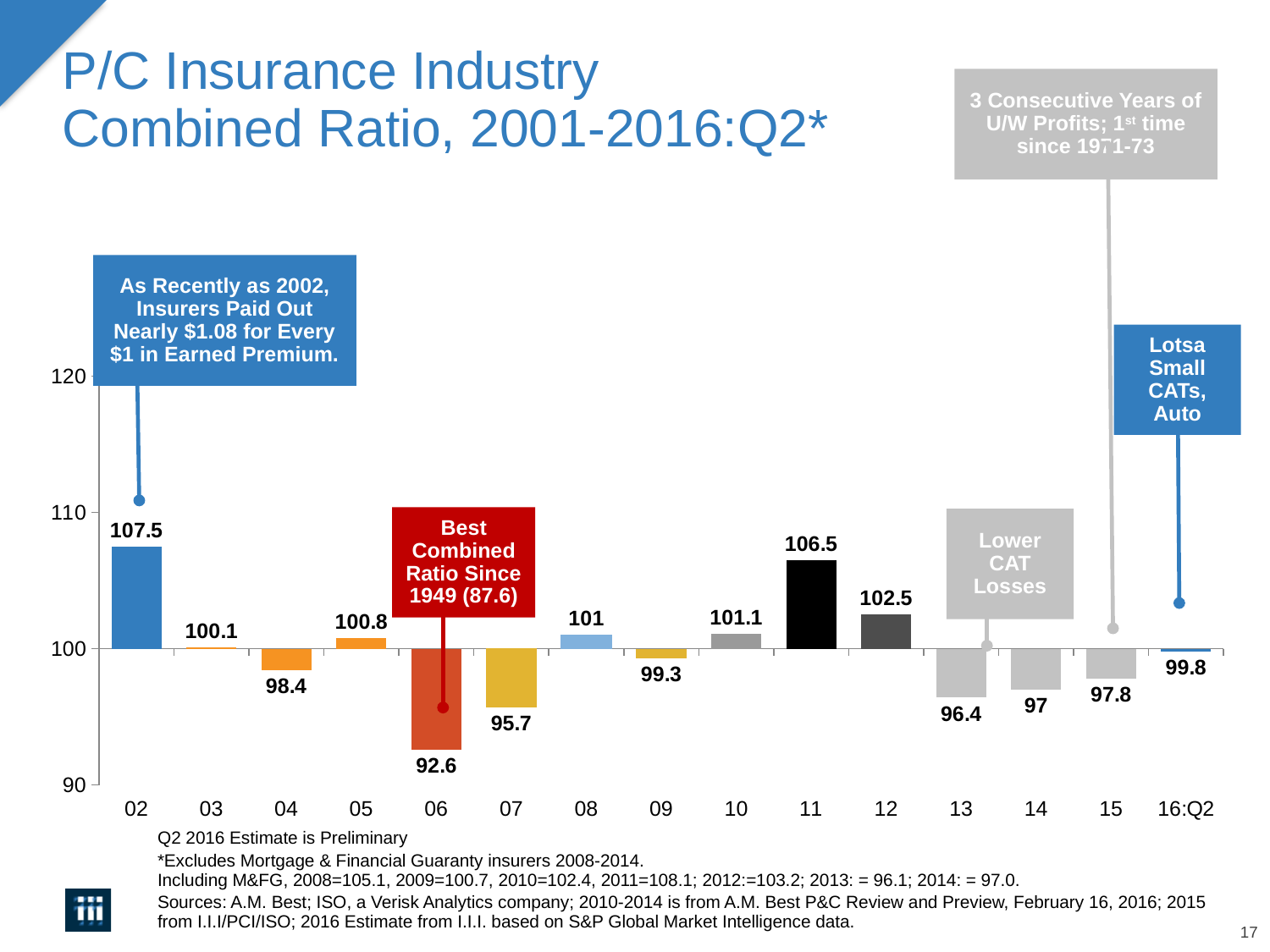
What is the combined ratio for 2011? 106.5 Is the value for 2013 greater or less than 100? less What is the title of the chart? P/C Insurance Industry Combined Ratio, 2001-2016:Q2* Do the values rise or fall from 2013 to 2015? rise Which year has the lowest combined ratio? 06 What is the combined ratio for 16:Q2? 99.8 Which year has the highest combined ratio? 02 How many years are shown on the x axis? 15 What kind of chart is this? bar chart What is the combined ratio for 2002? 107.5 What is the difference between the combined ratio for 2002 and 2006? 14.9 Which is larger, the combined ratio for 2011 or 2012? 2011